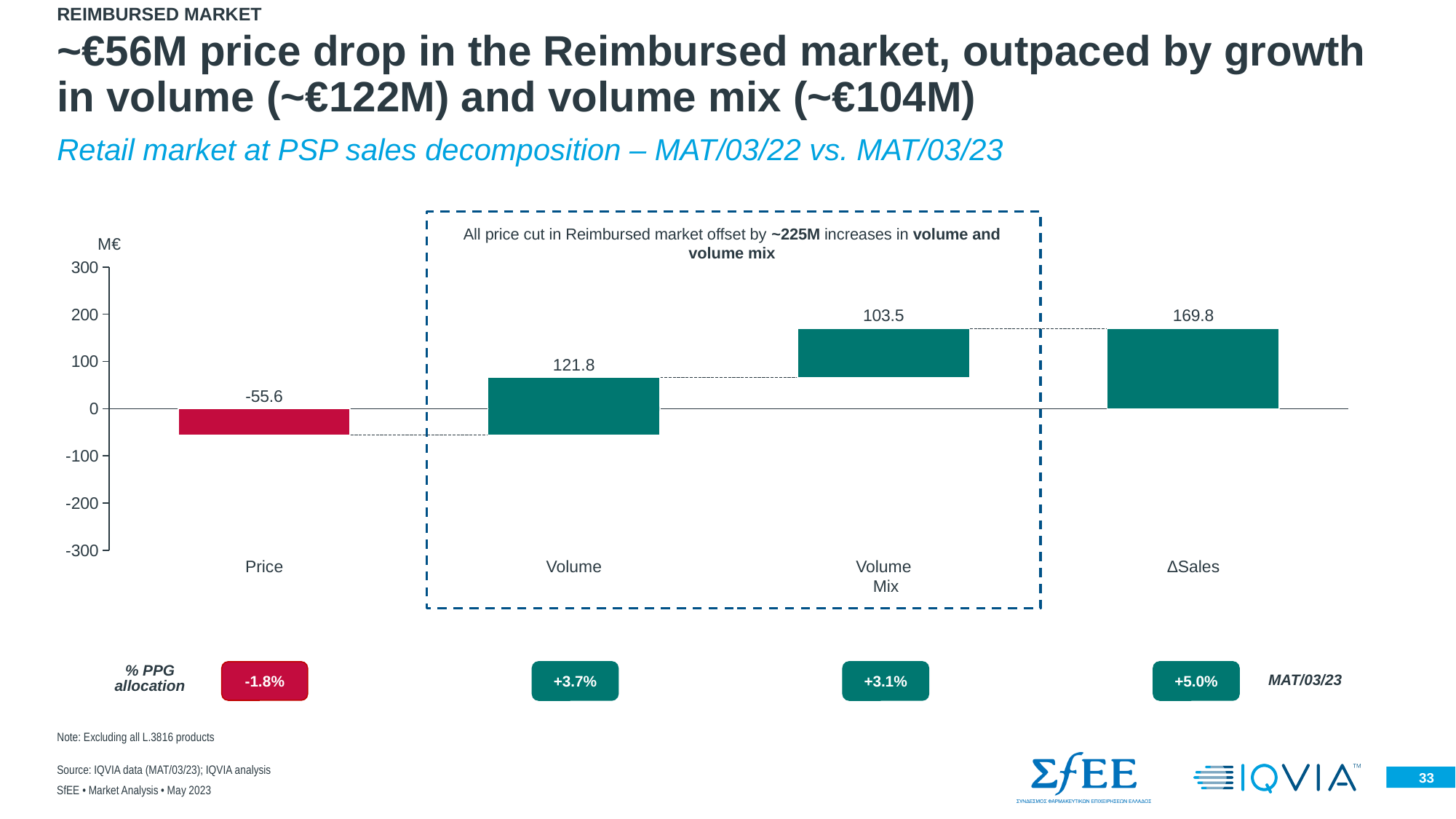
What is the difference between the Volume value and the Volume Mix value? 18.3 What is the value for ΔSales in the chart? 169.8 What is the value for Volume Mix in the chart? 103.5 What is the value for Volume in the chart? 121.8 Is the value for ΔSales greater or less than 100? greater How many categories are shown on the x axis of the chart? 4 What kind of chart is shown on the slide? bar chart Which is larger, the value for Volume or the value for Volume Mix? Volume Which category has the lowest value in the chart? Price What is the value for Price in the chart? -55.6 What is the % PPG allocation shown below the Volume bar? +3.7% Which category has the highest value in the chart? ΔSales